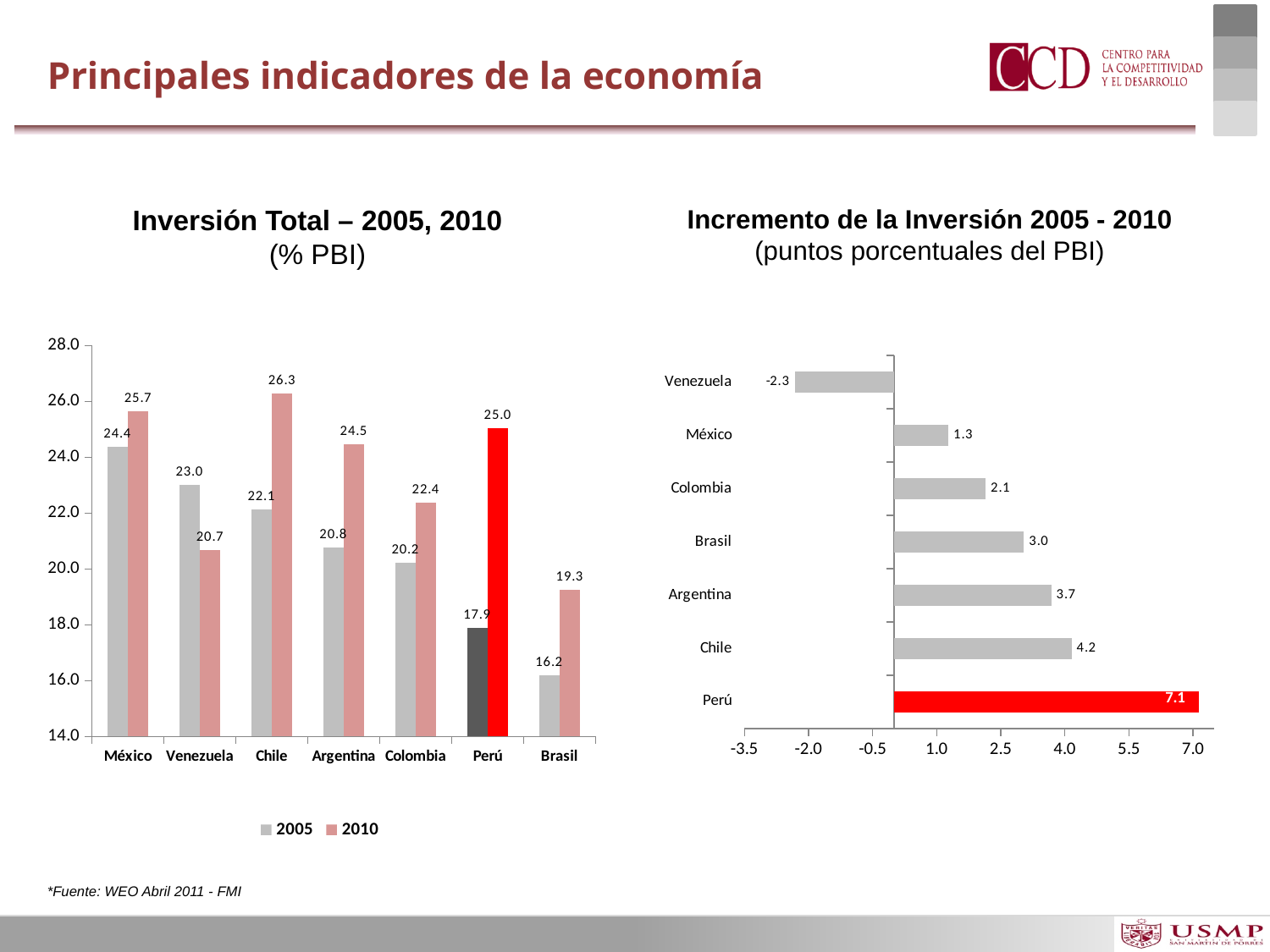
In the 'Inversión Total – 2005, 2010' chart, is Venezuela's 2005 value or its 2010 value larger? 2005 In the 'Incremento de la Inversión 2005 - 2010' chart, what is the difference between the values for Perú and Chile? 2.9 In the 'Incremento de la Inversión 2005 - 2010' chart, what is the value for Argentina? 3.7 In the 'Inversión Total – 2005, 2010' chart, which country has the lowest 2005 value? Brasil What kind of chart is the 'Incremento de la Inversión 2005 - 2010' chart? Bar chart In the 'Incremento de la Inversión 2005 - 2010' chart, which country has the lowest value? Venezuela In the 'Inversión Total – 2005, 2010' chart, what is the 2005 value for Perú? 17.9 In the 'Inversión Total – 2005, 2010' chart, what is the difference between Perú's 2010 and 2005 values? 7.1 In the 'Inversión Total – 2005, 2010' chart, which country has the highest 2010 value? Chile In the 'Inversión Total – 2005, 2010' chart, what is the 2010 value for Chile? 26.3 How many series does the legend of the 'Inversión Total – 2005, 2010' chart list? 2 How many countries are shown in the 'Inversión Total – 2005, 2010' chart? 7